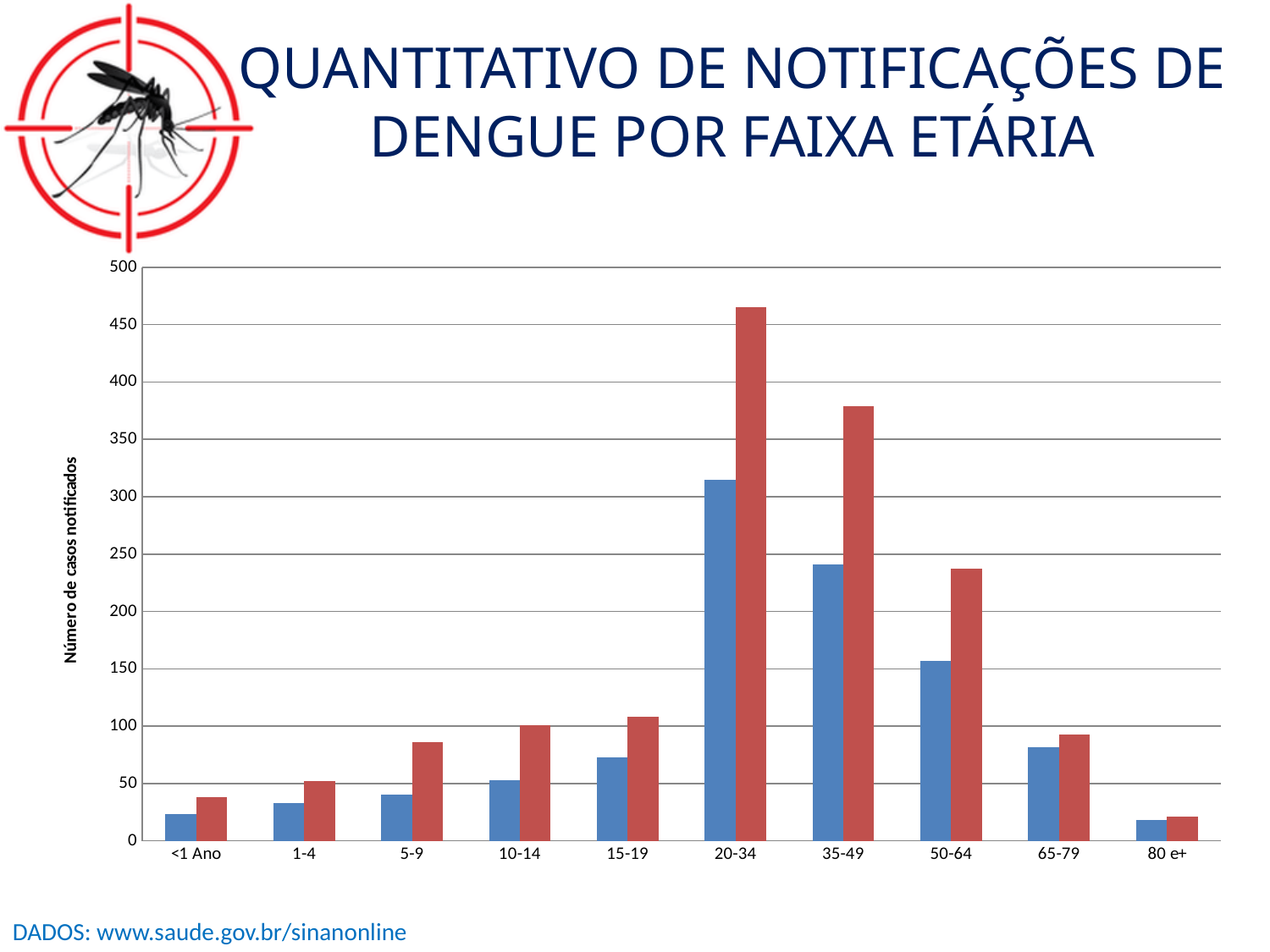
How many age-group categories are shown on the x axis? 10 Is the blue bar for the 50-64 age group greater or less than 100? greater Do the red bars rise or fall from the 20-34 age group to the 80 e+ age group? fall Is the red bar for the 50-64 age group greater or less than 250? less Is the red bar for the 20-34 age group greater or less than 450? greater Which is larger, the red bar for 20-34 or the red bar for 35-49? 20-34 Which age group has the tallest red bar? 20-34 Which age group has the shortest red bar? 80 e+ Which age group has the tallest blue bar? 20-34 What kind of chart is shown on the slide? bar chart What is the label on the vertical axis? Número de casos notificados